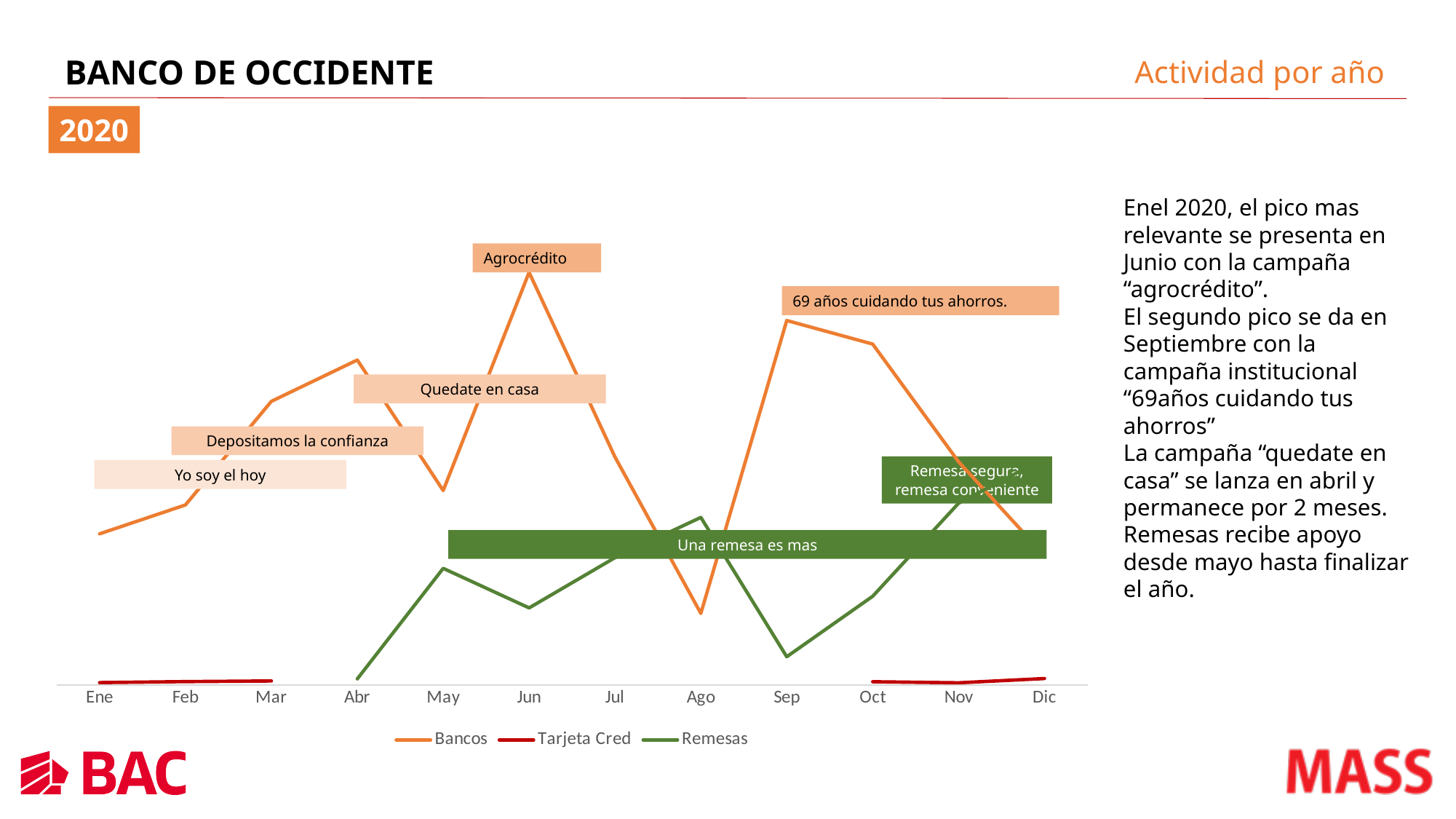
Between May and Dec, in which month is the Remesas series lowest? Sep Which series is higher in Ago: Bancos or Remesas? Remesas In which month does the Bancos series reach its lowest value? Ago Which series is drawn in green in the chart? Remesas In which month does the Bancos series reach its highest value? Jun In which month does the Remesas series reach its highest value? Dic How many series does the chart legend list? 3 Does the Bancos series rise or fall from Jun to Ago? Fall Does the Remesas series rise or fall from Sep to Nov? Rise Which is larger for the Bancos series: the value in Jun or the value in Sep? Jun What kind of chart is shown on the slide? Line chart How many months are shown on the x axis of the chart? 12